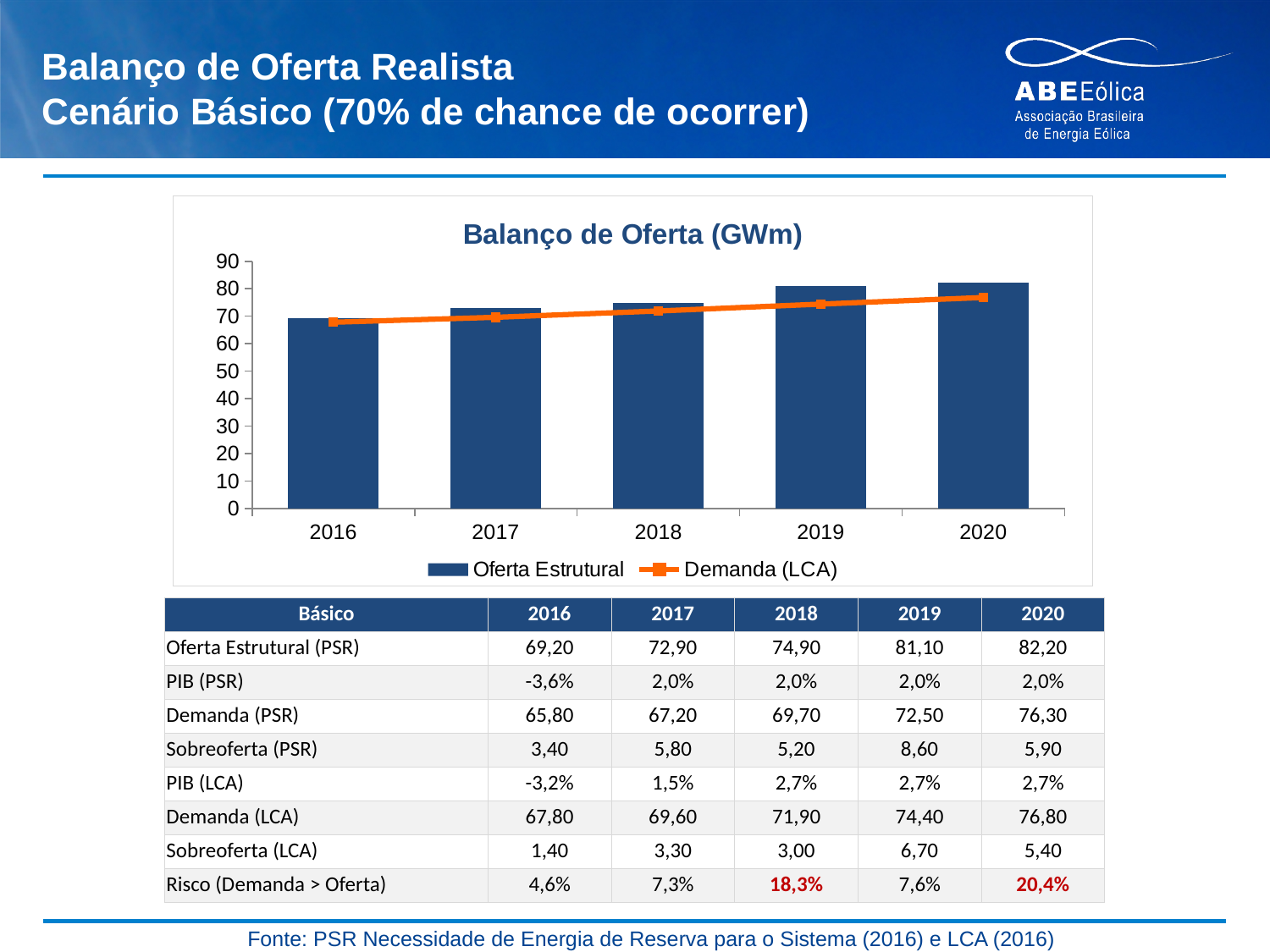
According to the table, what is the Demanda (LCA) value for 2018? 71,90 What colour are the Oferta Estrutural bars in the "Balanço de Oferta (GWm)" chart? Dark blue How many series does the legend of the "Balanço de Oferta (GWm)" chart list? 2 According to the table, what is the Oferta Estrutural (PSR) value for 2020? 82,20 Is the Oferta Estrutural value for 2016 greater or less than 70 in the "Balanço de Oferta (GWm)" chart? less Do the Demanda (LCA) values rise or fall from 2016 to 2020 in the "Balanço de Oferta (GWm)" chart? Rise Which year has the highest Oferta Estrutural bar in the "Balanço de Oferta (GWm)" chart? 2020 In 2019, which is larger in the "Balanço de Oferta (GWm)" chart: Oferta Estrutural or Demanda (LCA)? Oferta Estrutural Is the Oferta Estrutural value for 2019 greater or less than 80 in the "Balanço de Oferta (GWm)" chart? greater Which year has the lowest Oferta Estrutural bar in the "Balanço de Oferta (GWm)" chart? 2016 What kind of chart is shown under the title "Balanço de Oferta (GWm)"? A bar chart combined with a line chart How many years are shown on the x axis of the "Balanço de Oferta (GWm)" chart? 5